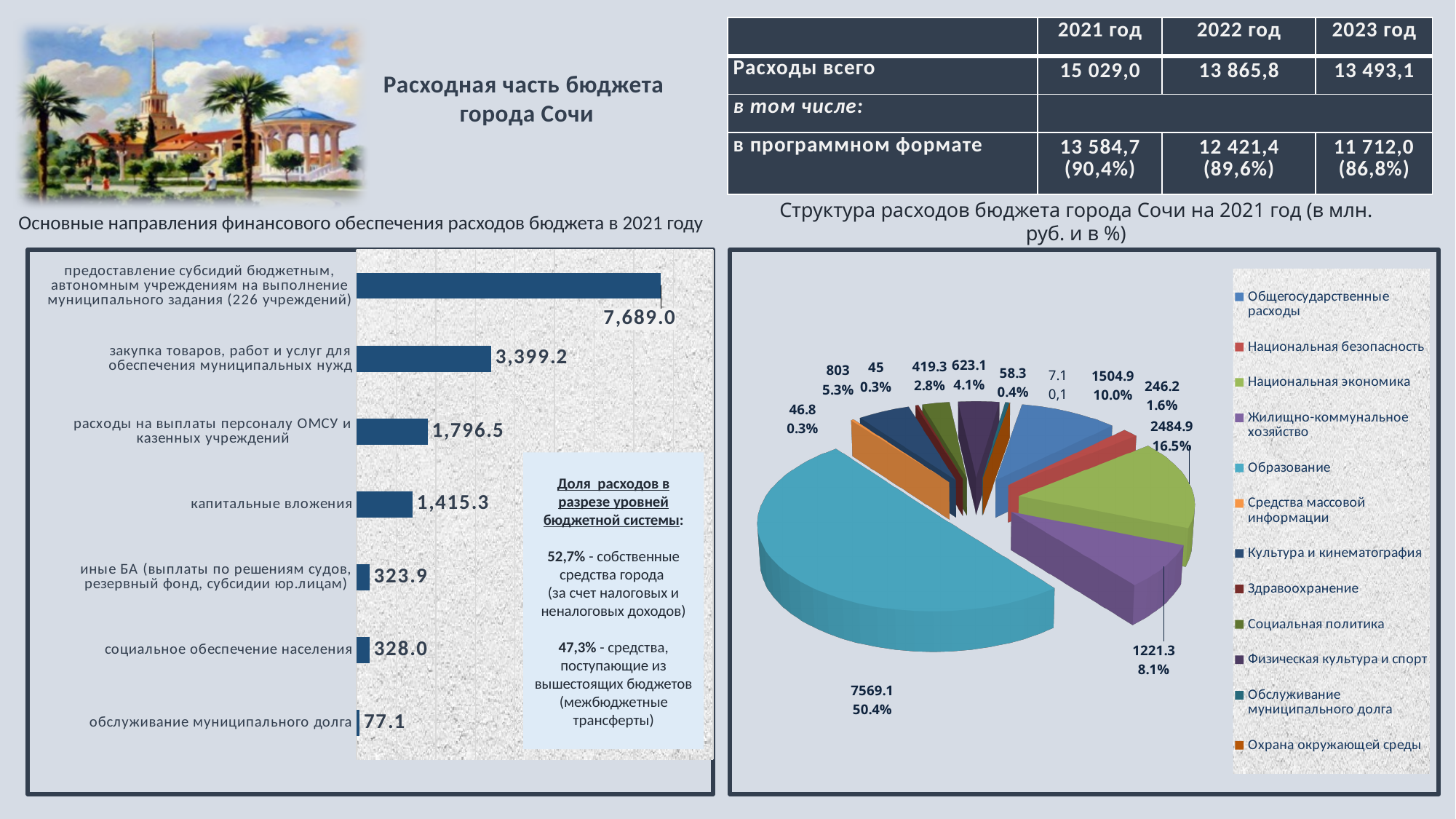
In the left bar chart, what is the difference between the value for 'предоставление субсидий бюджетным, автономным учреждениям...' (7,689.0) and 'закупка товаров, работ и услуг...' (3,399.2)? 4,289.8 In the right pie chart, how many entries does the legend list? 12 In the left bar chart, which category has the highest value? предоставление субсидий бюджетным, автономным учреждениям на выполнение муниципального задания (226 учреждений) In the left bar chart, what is the value for 'закупка товаров, работ и услуг для обеспечения муниципальных нужд'? 3,399.2 In the left bar chart, which is larger: 'социальное обеспечение населения' or 'иные БА (выплаты по решениям судов, резервный фонд, субсидии юр.лицам)'? социальное обеспечение населения In the left bar chart, how many categories are shown? 7 In the left bar chart, what is the value for 'капитальные вложения'? 1,415.3 In the right pie chart, what is the value (in million rubles) for 'Национальная экономика'? 2484.9 What kind of chart is the right chart titled 'Структура расходов бюджета города Сочи на 2021 год'? pie chart In the right pie chart, what share of the total does 'Образование' account for? 50.4% In the left bar chart, which category has the lowest value? обслуживание муниципального долга What kind of chart is the left chart titled 'Основные направления финансового обеспечения расходов бюджета в 2021 году'? bar chart